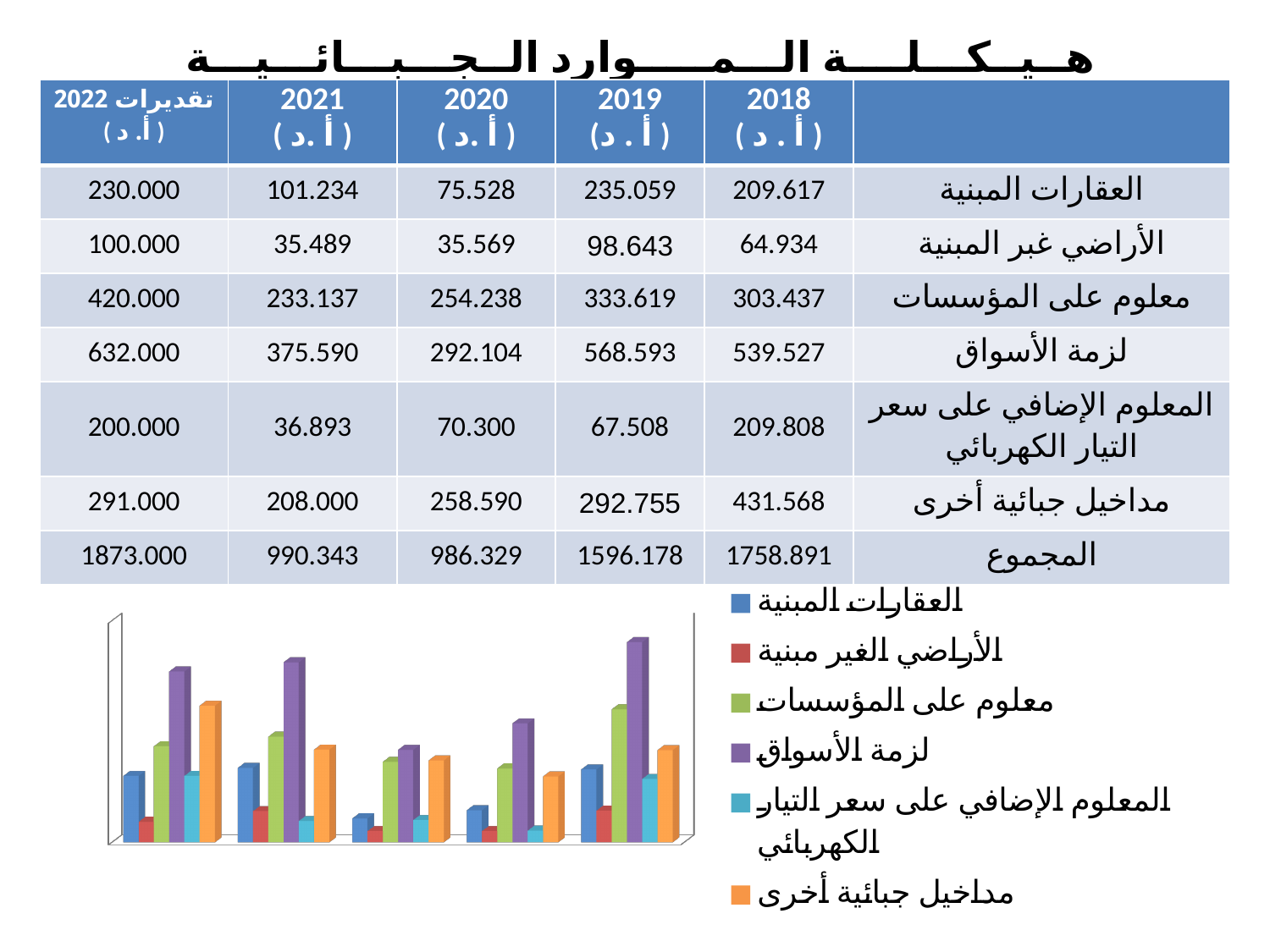
Which series is shown in orange in the chart's legend? مداخيل جبائية أخرى How many series does the chart's legend list? 6 Which group of bars contains the tallest bar for لزمة الأسواق? the rightmost group In the rightmost group of bars, which series has the tallest bar? لزمة الأسواق In the rightmost group of bars, which is taller: the bar for معلوم على المؤسسات or the bar for مداخيل جبائية أخرى? معلوم على المؤسسات In the leftmost group of bars, which series has the shortest bar? الأراضي الغير مبنية How many groups of bars are plotted in the chart? 5 In the middle (third) group of bars, which series has the shortest bar? الأراضي الغير مبنية In the leftmost group of bars, which series has the tallest bar? لزمة الأسواق Which colour represents لزمة الأسواق in the chart? purple What kind of chart is shown at the bottom of the slide? bar chart In the second group of bars from the left, which is taller: the bar for العقارات المبنية or the bar for الأراضي الغير مبنية? العقارات المبنية